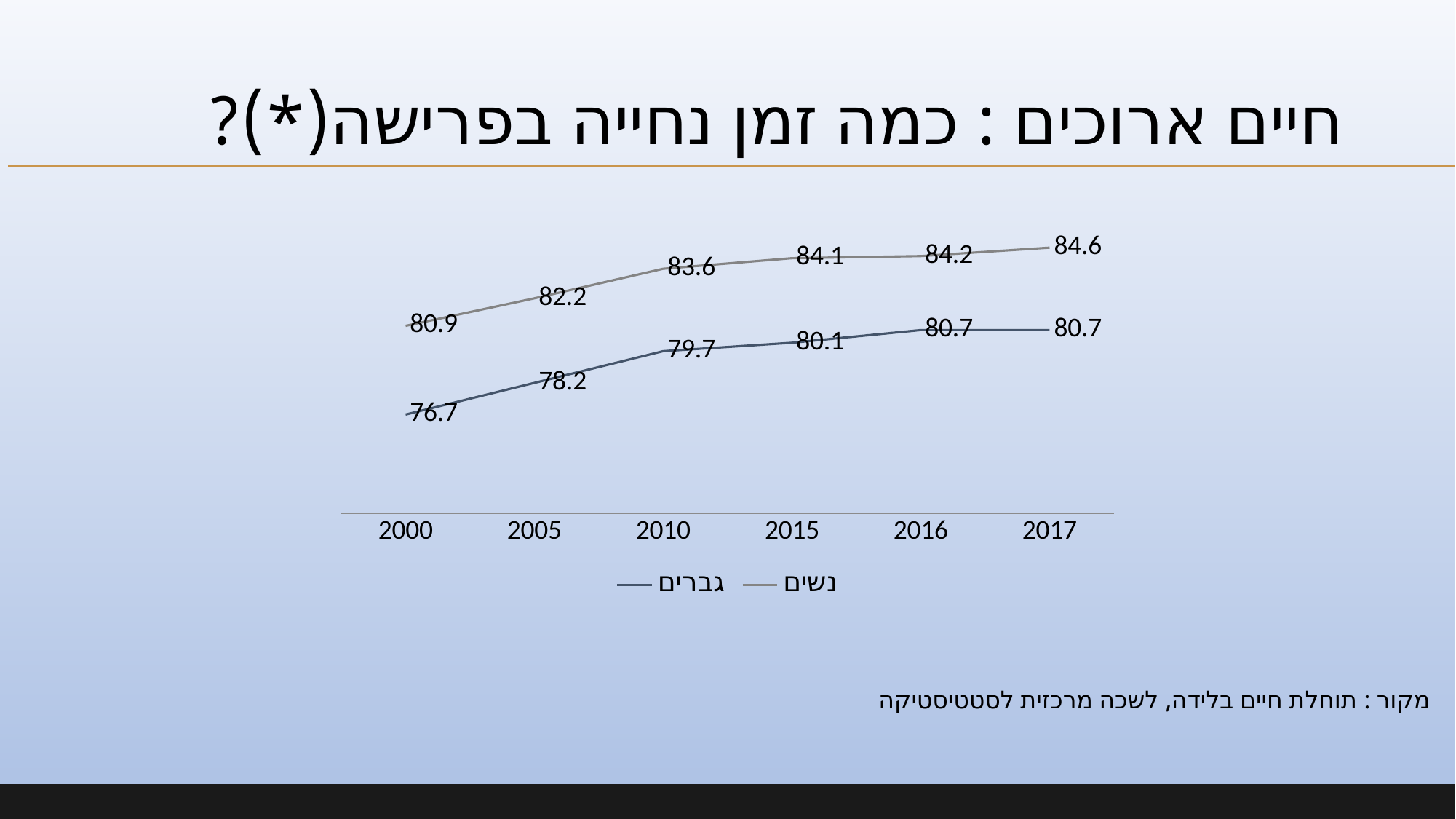
What is the difference between the נשים and גברים values in 2017? 3.9 Which series has the higher value in 2015, נשים or גברים? נשים How many series does the legend list? 2 What is the value for גברים in 2005? 78.2 What is the value for גברים in 2010? 79.7 What is the value for נשים in 2000? 80.9 In which year is the value for גברים lowest? 2000 What type of chart is shown on the slide? line chart What is the value for נשים in 2017? 84.6 In which year is the value for נשים highest? 2017 Do the values for נשים rise or fall from 2000 to 2017? rise How many years are shown on the x axis? 6